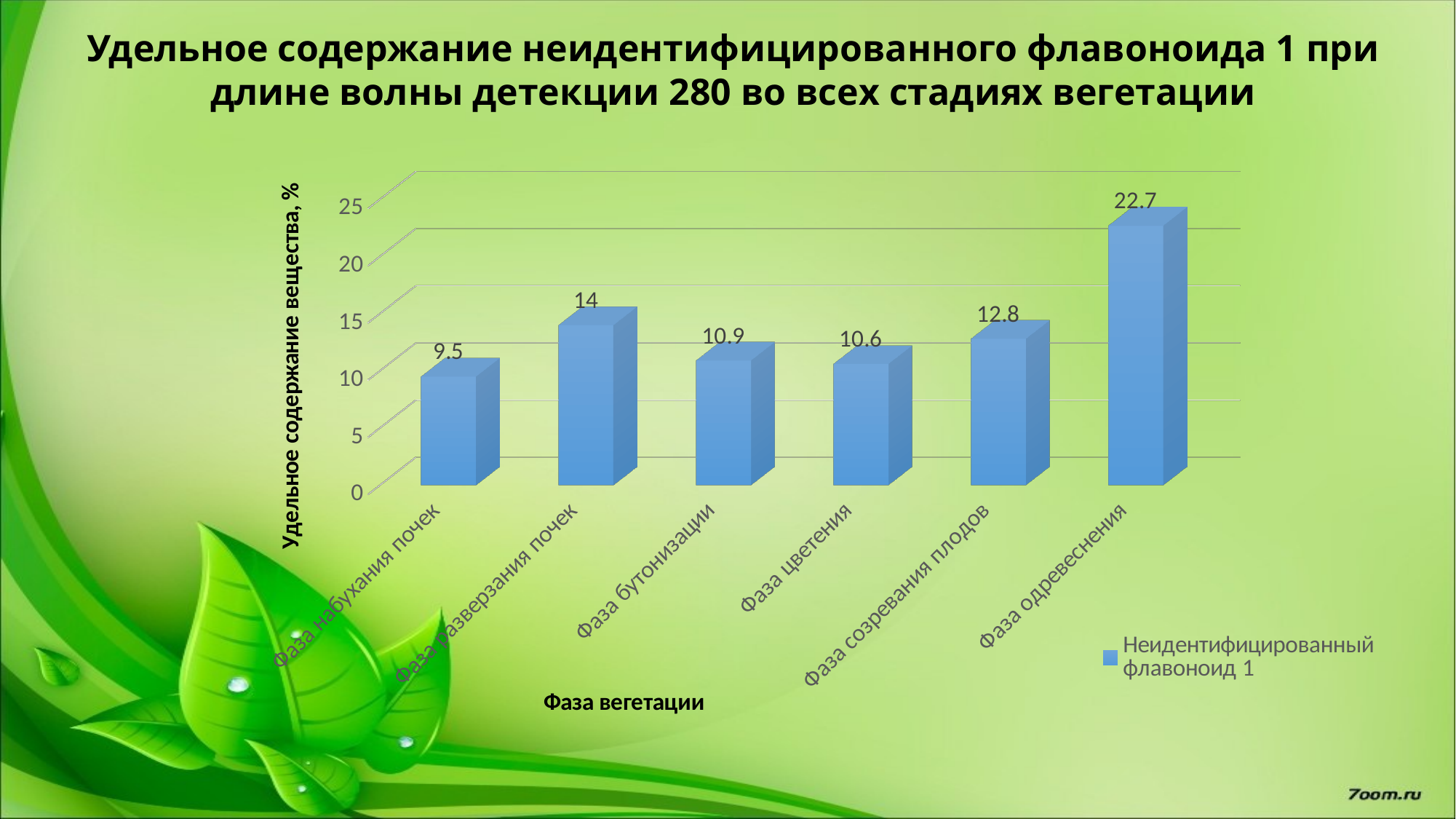
Which is larger, the value for Фаза бутонизации or Фаза цветения? Фаза бутонизации How many vegetation phases are shown on the x axis? 6 What series does the legend list? Неидентифицированный флавоноид 1 What is the value for Фаза одревеснения? 22.7 What kind of chart is shown on the slide? bar chart What is the value for Фаза разверзания почек? 14 Is the value for Фаза одревеснения greater or less than 20? greater What is the value for Фаза созревания плодов? 12.8 What is the value for Фаза набухания почек? 9.5 What is the difference between the values for Фаза одревеснения and Фаза набухания почек? 13.2 Which phase has the lowest value? Фаза набухания почек Which phase has the highest value? Фаза одревеснения